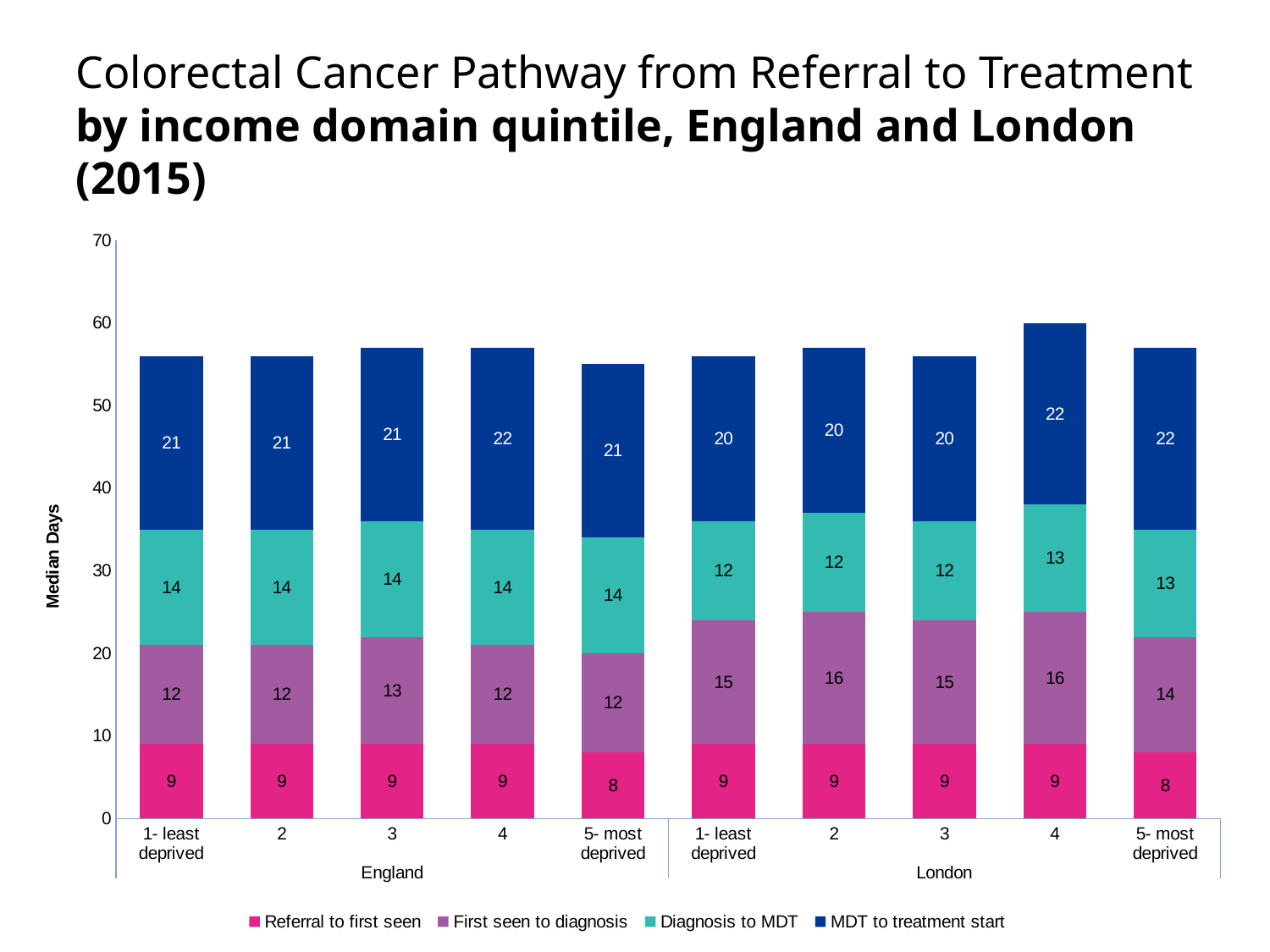
What is the median days for 'Referral to first seen' for the '5- most deprived' quintile in England? 8 How many series does the legend list? 4 What is the median days for 'MDT to treatment start' for quintile 4 in London? 22 Which bar has the highest total median days? 4 (London) What kind of chart is shown on the slide? Stacked bar chart What is the total median days for the quintile 4 bar in London? 60 What is the difference in 'First seen to diagnosis' median days between quintile 2 in London and quintile 2 in England? 4 Which is larger: 'Diagnosis to MDT' for quintile 3 in England or 'Diagnosis to MDT' for quintile 3 in London? Quintile 3 in England What is the median days for 'First seen to diagnosis' for quintile 2 in London? 16 What is the label of the y axis? Median Days How many bars are plotted in the chart? 10 What is the total median days for the '5- most deprived' bar in England? 55